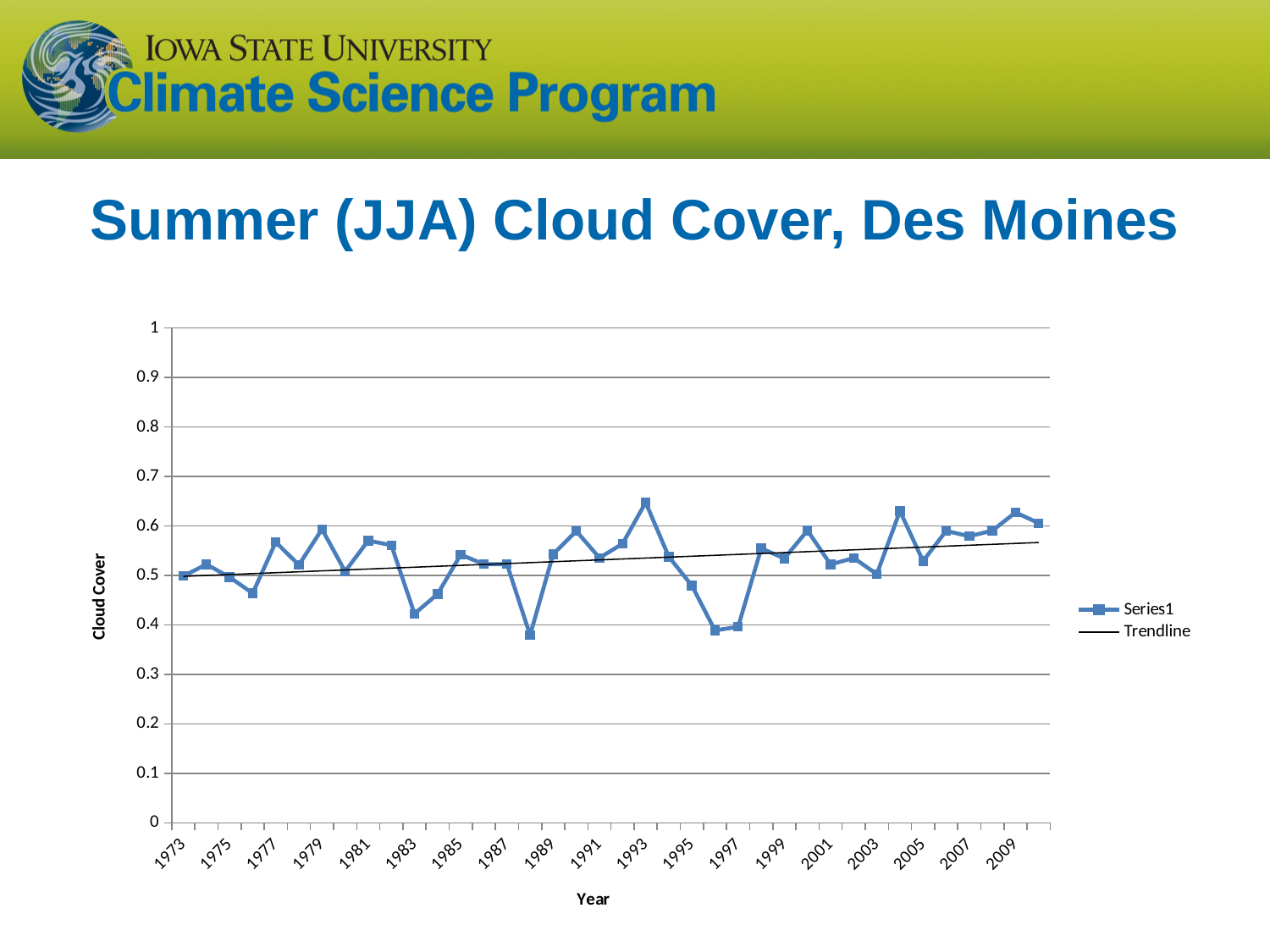
What kind of chart is shown on the slide? line chart What is the title of the vertical axis? Cloud Cover Does the trendline rise or fall from 1973 to 2010? rises Is the Series1 value for 2004 greater or less than 0.6? greater In which year does Series1 reach its highest cloud cover value? 1993 What are the two entries listed in the legend? Series1 and Trendline Which year has the larger Series1 value, 1996 or 2000? 2000 Is the Series1 value for 1983 greater or less than 0.5? less Is the Series1 value for 1993 greater or less than 0.6? greater In which year does Series1 reach its lowest cloud cover value? 1988 How many series does the legend list? 2